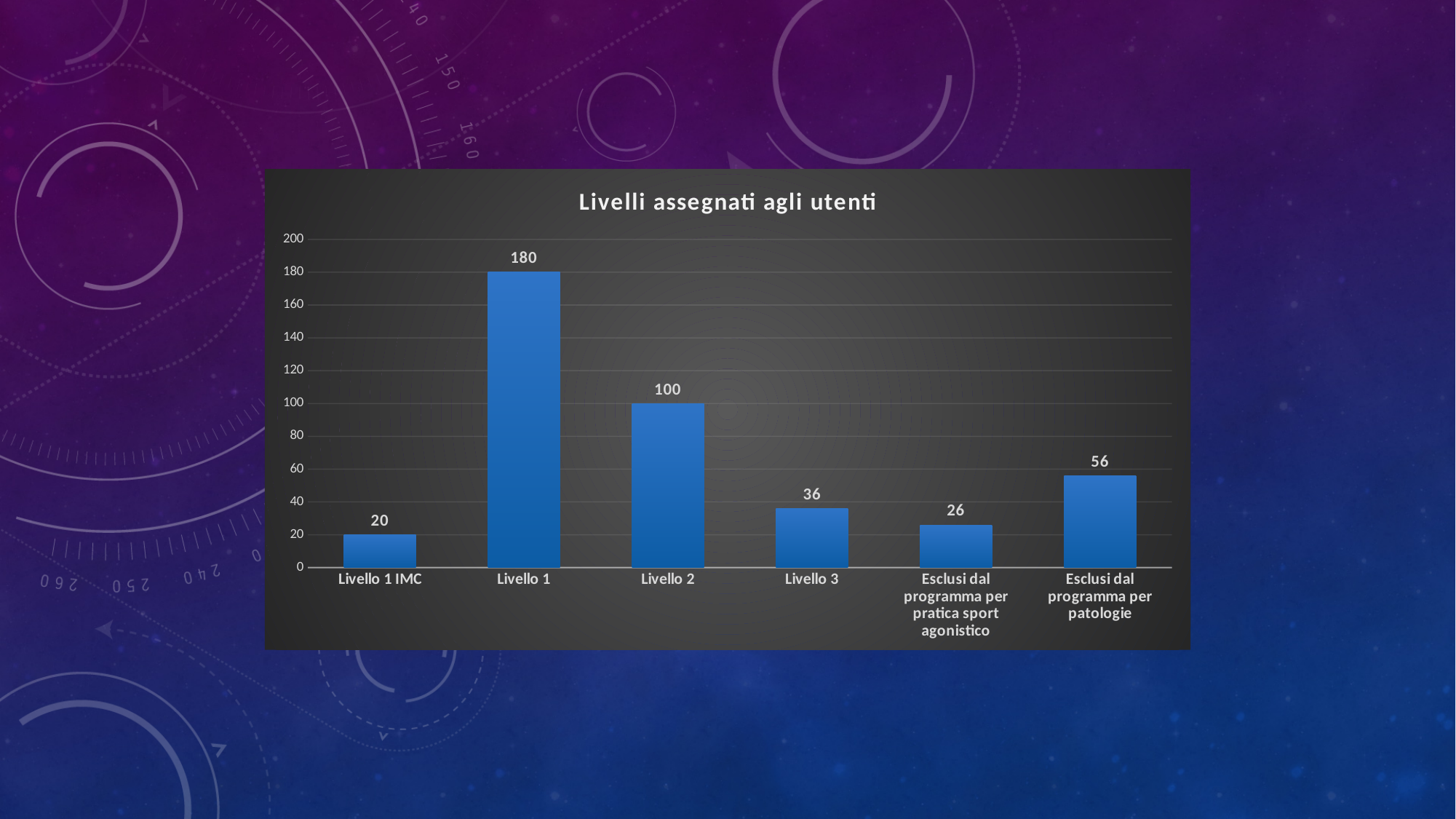
What is the value for Livello 1 IMC? 20 How many categories are shown on the x axis? 6 Which category has the highest value? Livello 1 What is the value for Livello 2? 100 Which is larger, the value for Livello 3 or the value for Esclusi dal programma per pratica sport agonistico? Livello 3 What is the value for Esclusi dal programma per patologie? 56 What kind of chart is shown on the slide? bar chart What is the value for Livello 1? 180 What is the difference between the values for Livello 1 and Livello 2? 80 Is the value for Esclusi dal programma per patologie greater or less than 40? greater Which category has the lowest value? Livello 1 IMC What is the title of the chart? Livelli assegnati agli utenti